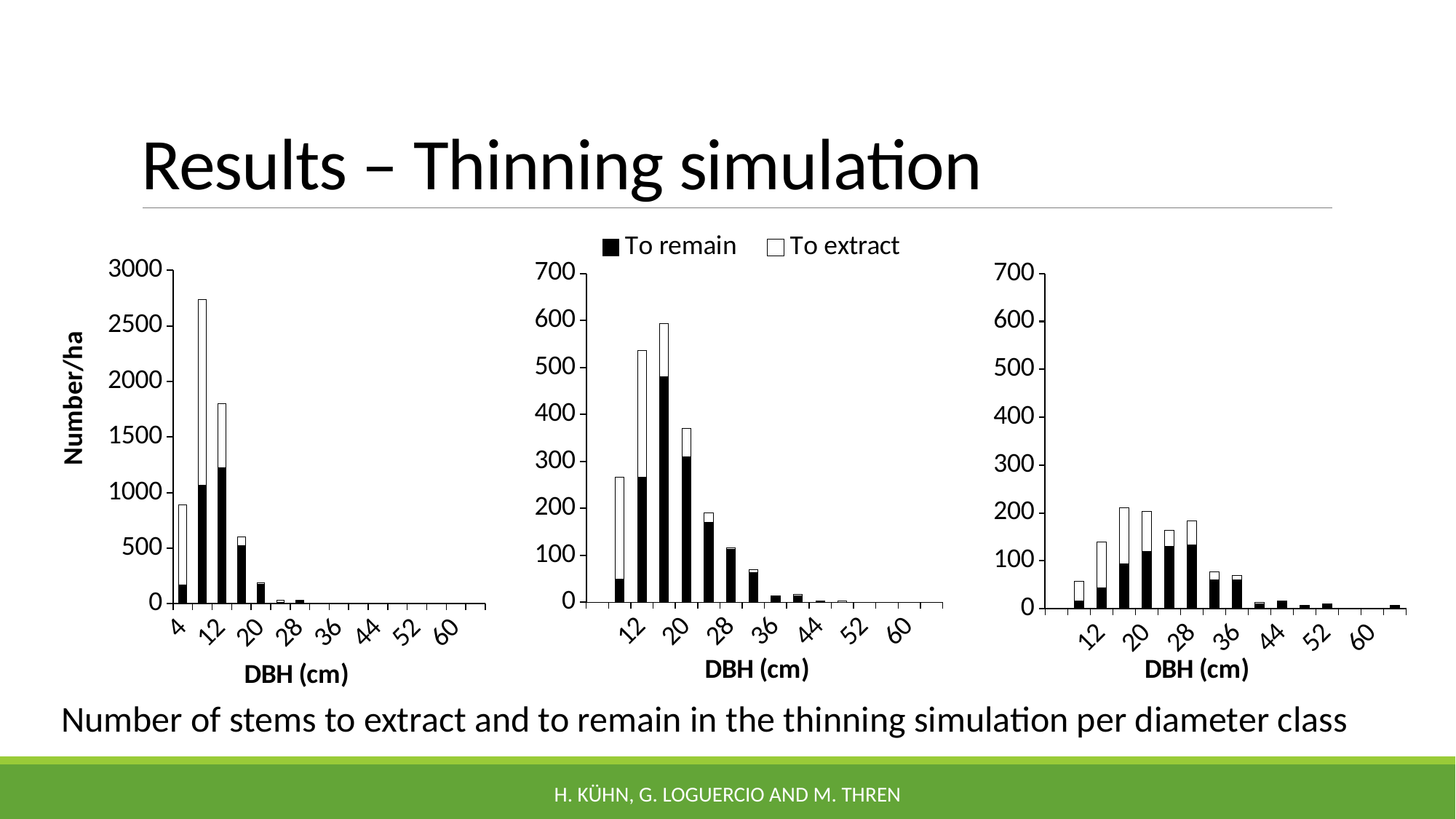
How many series does the legend list? 2 In the middle chart, is the total bar height for DBH 12 greater or less than 500? greater In the right chart, is the total bar height for DBH 36 greater or less than 100? less In the middle chart, which has the taller total bar, DBH 12 or DBH 28? DBH 12 What kind of chart is the left chart on the slide? Stacked bar chart In the left chart, is the total bar height for DBH 12 greater or less than 1500? greater What are the two series named in the legend? To remain, To extract What is the y-axis title of the left chart? Number/ha In the left chart, which has the taller total bar, DBH 12 or DBH 20? DBH 12